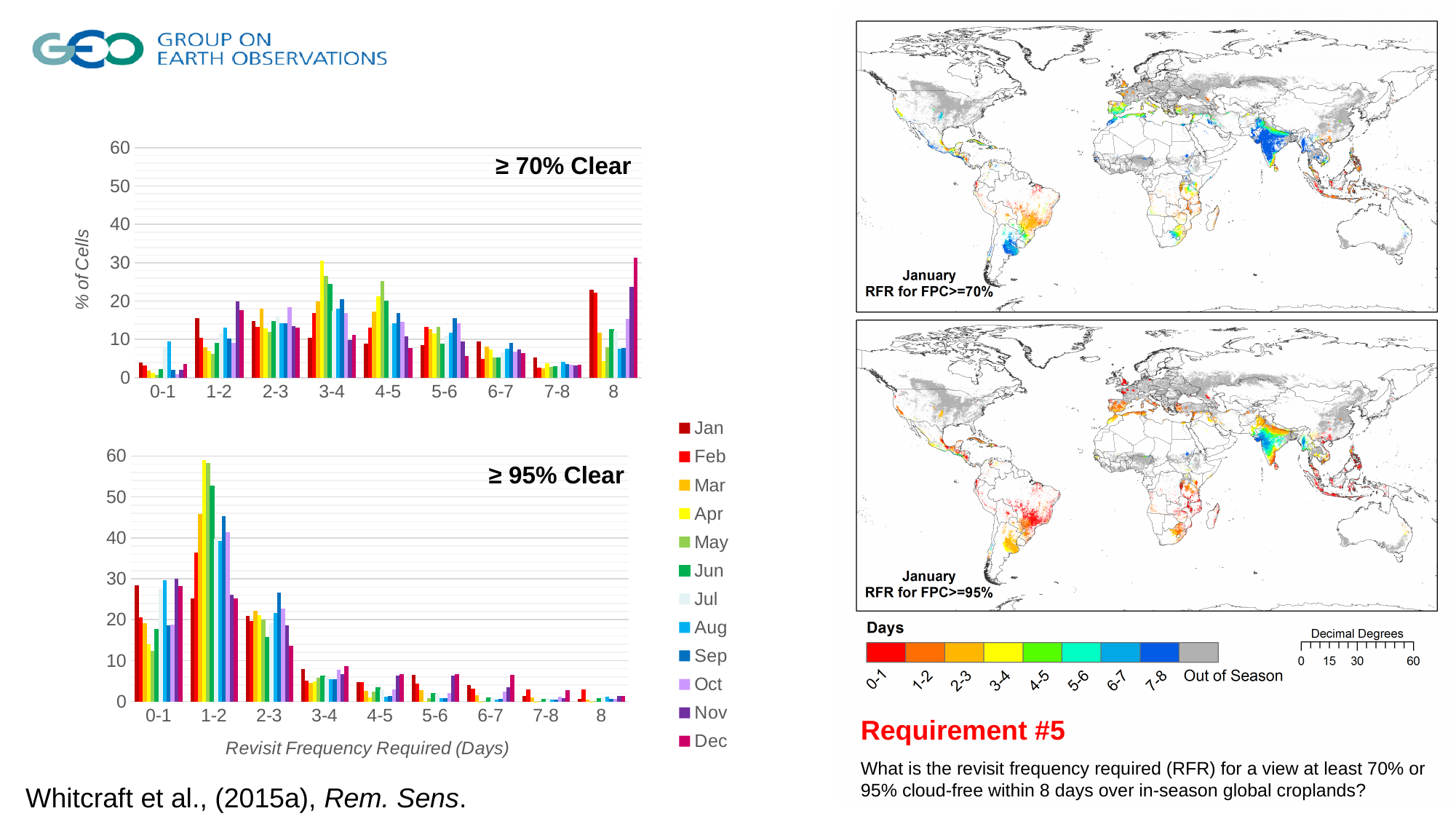
In the "≥ 70% Clear" chart, is the value for Jan in the 8 category greater or less than 20? greater What is the y-axis label of the "≥ 70% Clear" chart? % of Cells How many series does the legend shared by the two charts list? 12 In the "≥ 70% Clear" chart, which is larger for Jan: the 0-1 category or the 8 category? 8 How many revisit-frequency categories are shown on the x axis of the "≥ 95% Clear" chart? 9 In the "≥ 95% Clear" chart, do the bar heights generally rise or fall from the 1-2 category to the 8 category? fall In the "≥ 95% Clear" chart, which is larger for Apr: the 1-2 category or the 3-4 category? 1-2 In the "≥ 95% Clear" chart, which revisit-frequency category contains the tallest bar? 1-2 In the "≥ 70% Clear" chart, is the value for Feb in the 7-8 category greater or less than 10? less In the "≥ 95% Clear" chart, is the value for Jan in the 0-1 category greater or less than 20? greater What kind of chart is the "≥ 70% Clear" chart? bar chart